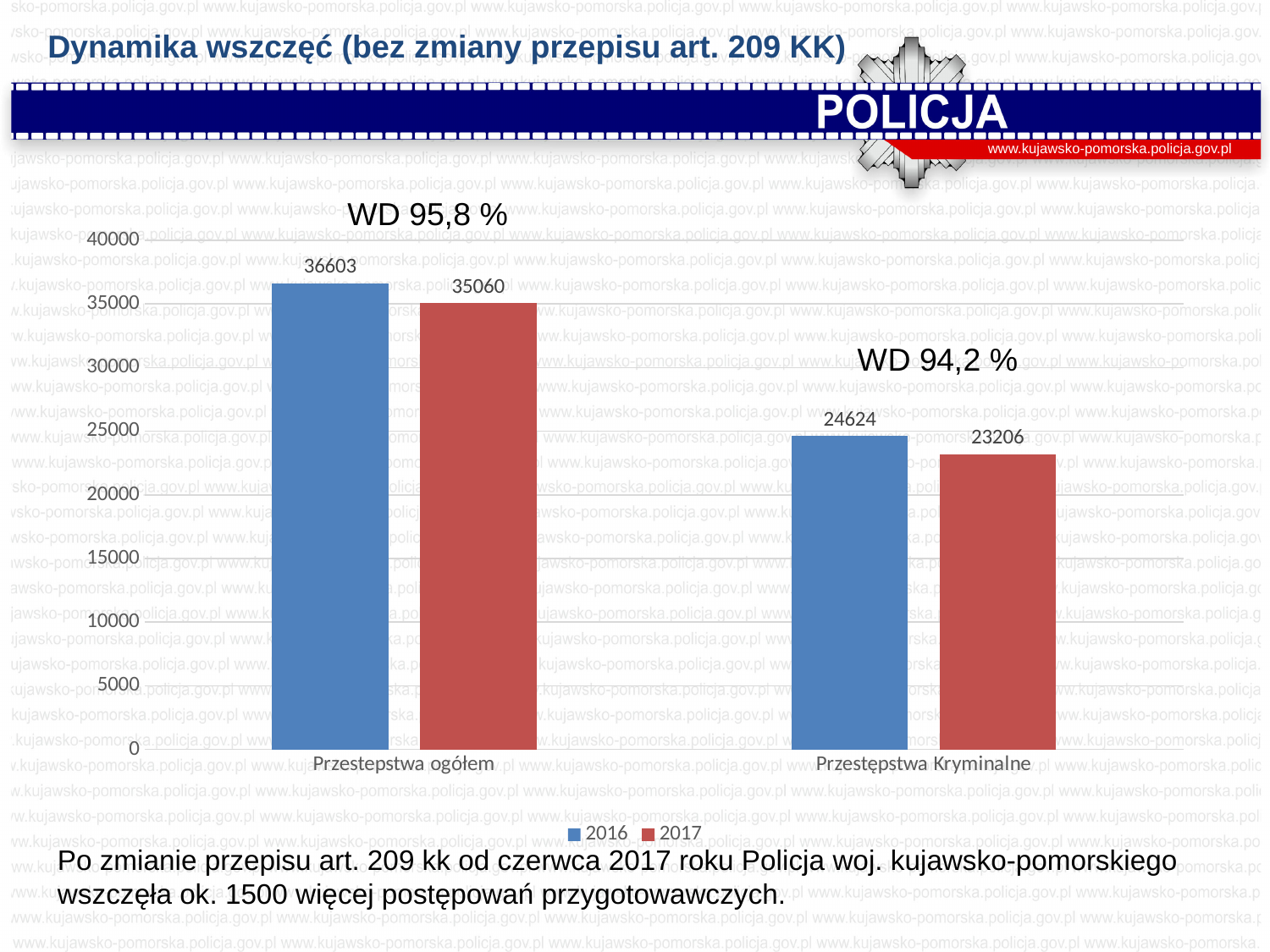
What is the value for 2017 for Przestępstwa Kryminalne? 23206 How many series does the legend list? 2 What kind of chart is shown on the slide? bar chart How many categories are shown on the x axis? 2 Which category has the lowest 2017 value? Przestępstwa Kryminalne What is the value for 2017 for Przestepstwa ogółem? 35060 What is the value for 2016 for Przestepstwa ogółem? 36603 Which is larger for Przestępstwa Kryminalne, the 2016 value or the 2017 value? 2016 What is the difference between the 2016 and 2017 values for Przestepstwa ogółem? 1543 What is the difference between the 2016 and 2017 values for Przestępstwa Kryminalne? 1418 What is the value for 2016 for Przestępstwa Kryminalne? 24624 Which category has the highest 2016 value? Przestepstwa ogółem